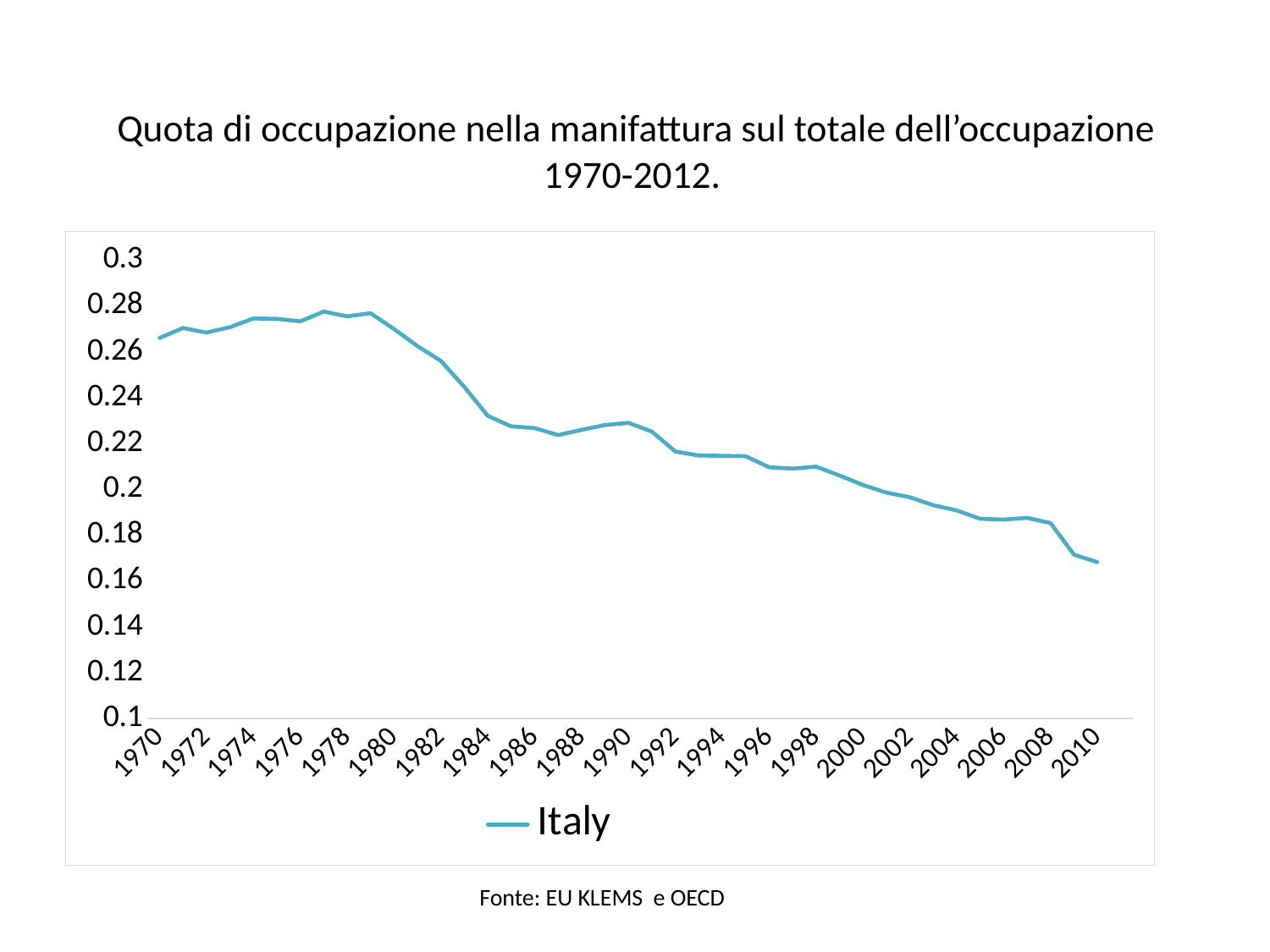
Which is larger, the value for 1980 or the value for 1990? 1980 Which year has the lowest value on the chart? 2010 What is the name of the series shown in the legend? Italy Is the value for 2010 greater or less than 0.18? less Is the value for 2000 greater or less than 0.22? less Is the value for 2006 greater or less than 0.2? less How many series does the legend list? 1 What kind of chart is shown on the slide? line chart Overall, do the values rise or fall from 1970 to 2010? fall What is the title of the chart? Quota di occupazione nella manifattura sul totale dell'occupazione 1970-2012.